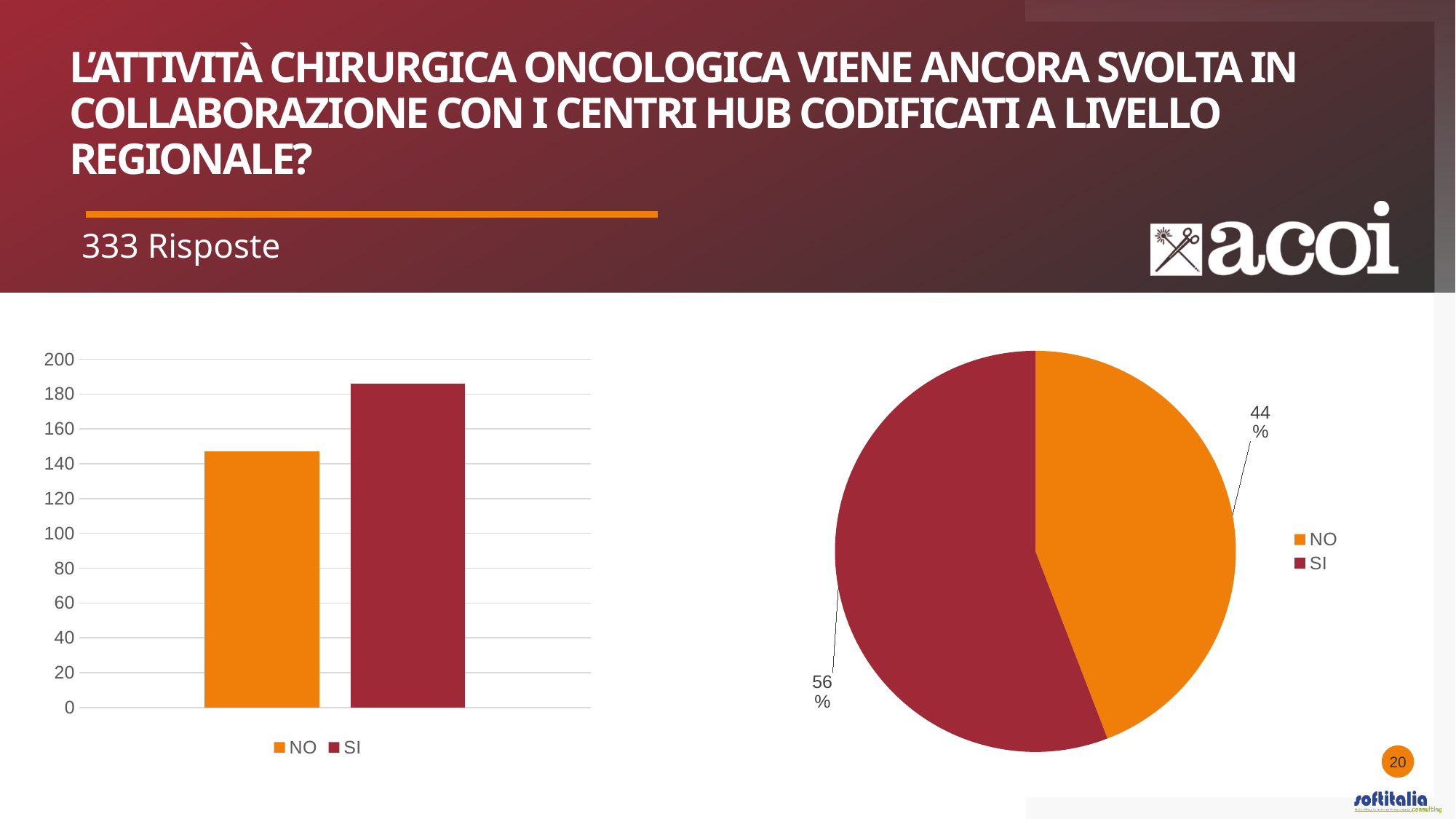
In the pie chart on the right, what share of responses is SI? 56% In the bar chart on the left, is the value for NO greater or less than 160? less What kind of chart is the chart on the left of the slide? bar chart In the bar chart on the left, which category has the lowest bar? NO What kind of chart is the chart on the right of the slide? pie chart In the pie chart on the right, which slice is larger, NO or SI? SI In the pie chart on the right, what share of responses is NO? 44% How many series does the legend of the bar chart on the left list? 2 In the pie chart on the right, what colour is the SI slice? dark red In the pie chart on the right, what is the difference in percentage points between the SI and NO slices? 12 In the bar chart on the left, which category has the highest bar? SI In the bar chart on the left, is the value for SI greater or less than 160? greater